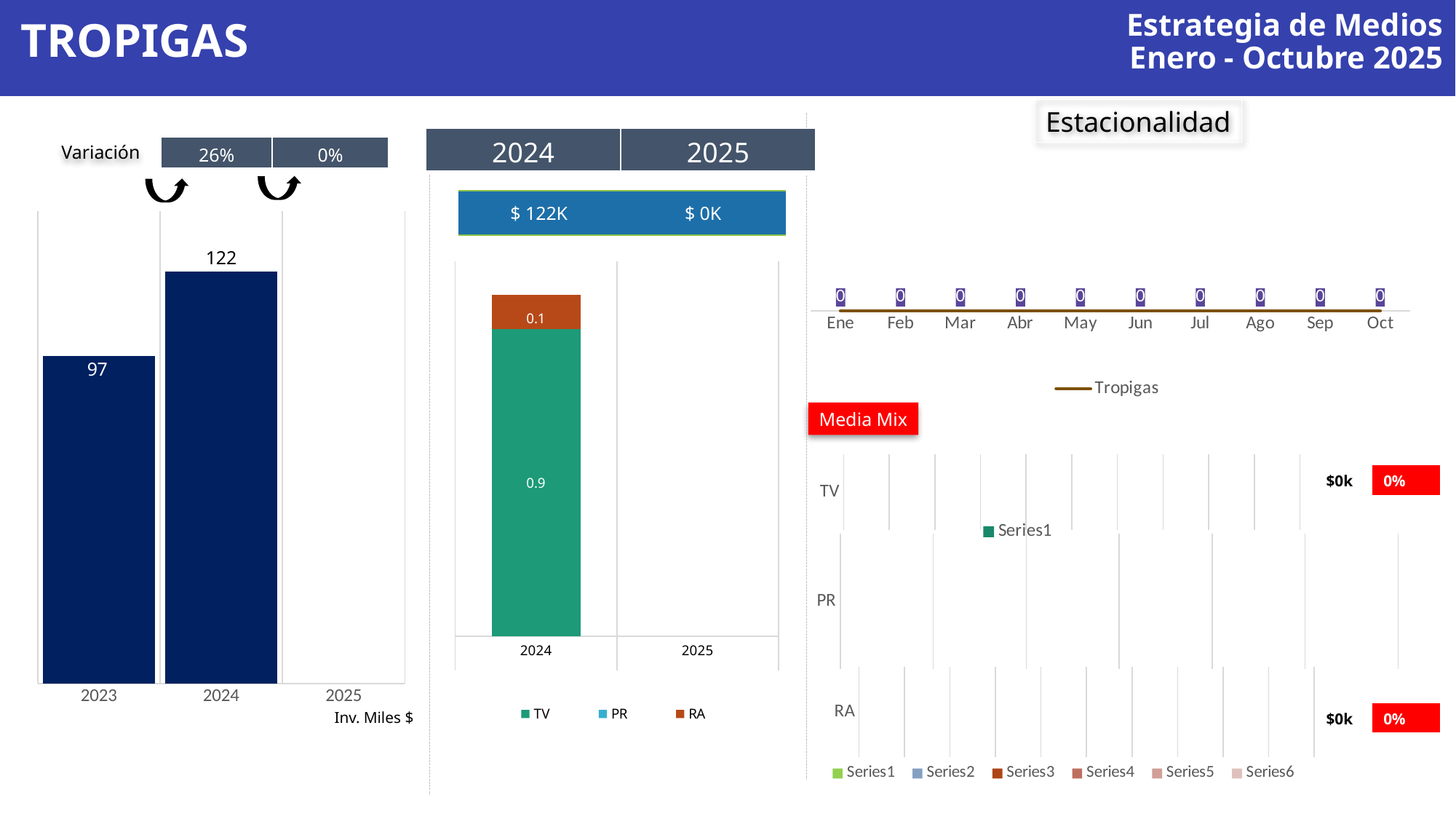
In the left bar chart (Inv. Miles $), which is larger, the value for 2023 or for 2024? 2024 In the middle stacked bar chart, what is the RA value for 2024? 0.1 In the middle stacked bar chart, what is the TV value for 2024? 0.9 In the left bar chart (Inv. Miles $), what is the difference between the 2024 and 2023 values? 25 In the left bar chart (Inv. Miles $), what is the value for 2024? 122 In the Estacionalidad chart, how many months are shown on the x axis? 10 What type of chart is the left chart labelled Inv. Miles $? bar chart How many series does the legend of the middle stacked bar chart list? 3 In the left bar chart (Inv. Miles $), what is the value for 2023? 97 In the left bar chart (Inv. Miles $), which year has the highest value? 2024 How many series does the legend of the Media Mix chart list? 6 In the Estacionalidad chart, what is the value for Mar? 0